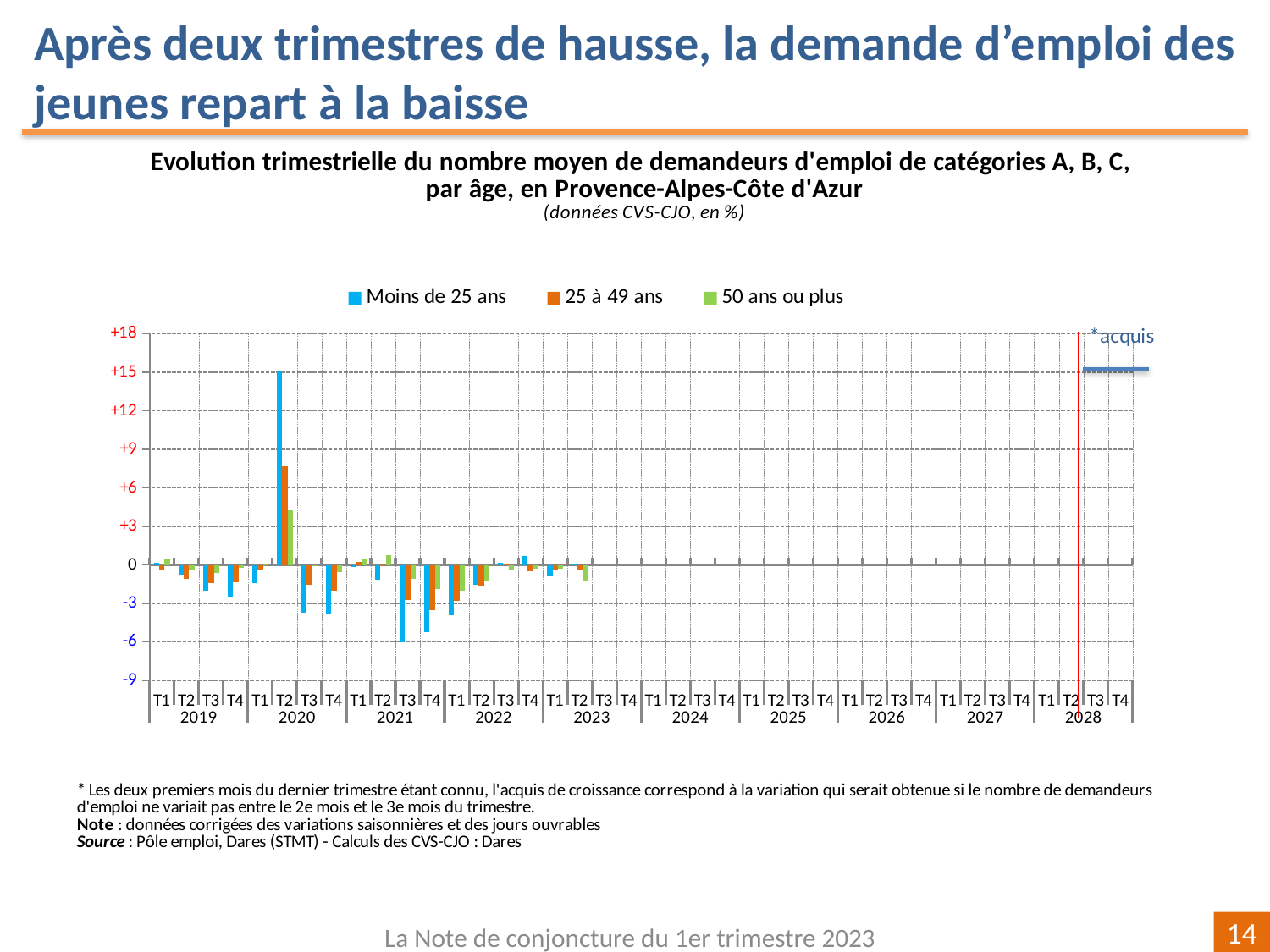
In T2 2020, which series has the larger value: 'Moins de 25 ans' or '25 à 49 ans'? Moins de 25 ans How many years are labelled along the x axis? 10 Is the value for '25 à 49 ans' in T2 2020 greater or less than +6? greater In which quarter does the 'Moins de 25 ans' series reach its lowest value? T3 2021 Is the value for 'Moins de 25 ans' in T2 2020 greater or less than +12? greater How many series does the legend list? 3 Is the value for 'Moins de 25 ans' in T4 2021 greater or less than -3? less What label appears next to the vertical red line at the right of the chart? *acquis In which quarter does the 'Moins de 25 ans' series reach its highest value? T2 2020 Which age groups are listed in the legend? Moins de 25 ans, 25 à 49 ans, 50 ans ou plus What kind of chart is shown on the slide? bar chart